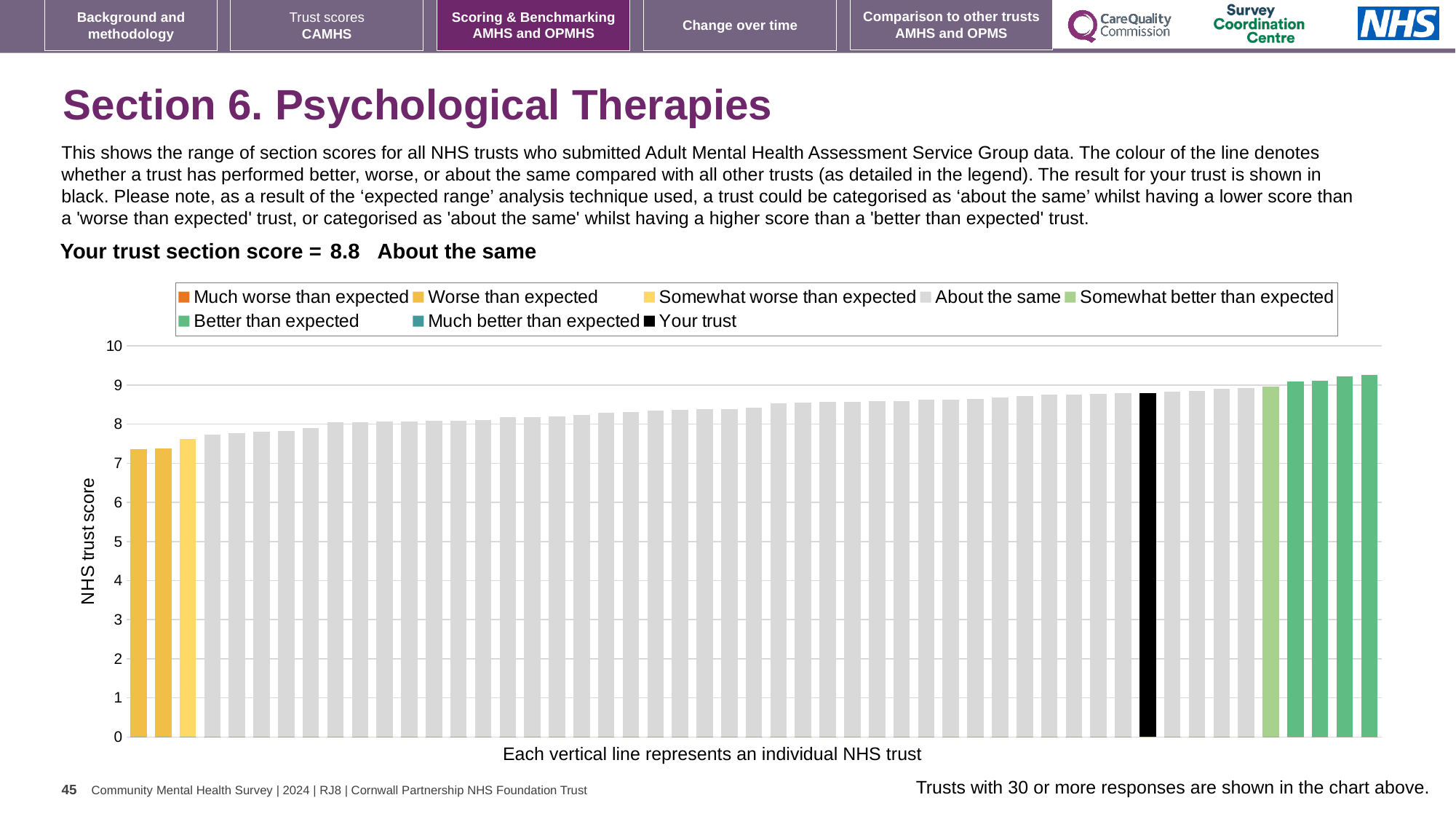
Is the value of the black 'Your trust' bar greater or less than 8? greater What is the label on the vertical axis of the chart? NHS trust score How many entries does the chart legend list? 8 Is the value of the rightmost bar greater or less than 9? greater Do the bar values rise or fall from left to right along the x axis? rise What colour is the bar representing your trust? black Which is larger, the leftmost bar or the black 'Your trust' bar? the black 'Your trust' bar Which category is your trust placed in for this section? About the same How many bars are coloured as 'Better than expected' (dark green)? 4 What is the section score for your trust shown on the slide? 8.8 What kind of chart is shown on the slide? bar chart Is the value of the leftmost bar greater or less than 8? less